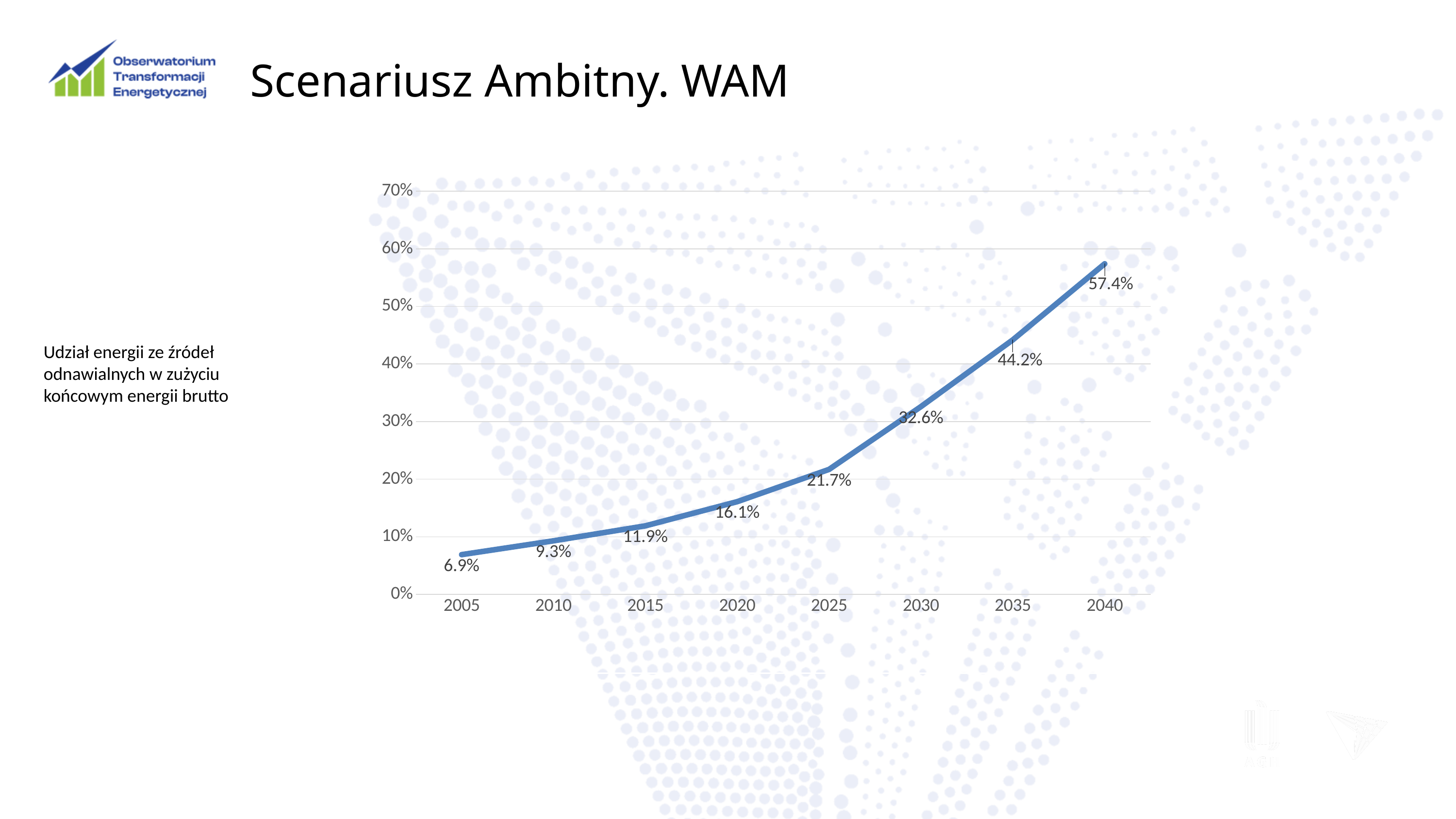
What is the difference between the values for 2020 and 2015? 4.2% What is the value for 2030? 32.6% Which year has the highest value? 2040 What kind of chart is shown on the slide? line chart How many data points are plotted on the line? 8 What is the value for 2040? 57.4% Do the values rise or fall from 2005 to 2040? rise What is the value for 2005? 6.9% What is the value for 2025? 21.7% What is the difference between the values for 2040 and 2035? 13.2% Which year has the lowest value? 2005 Which is larger, the value for 2010 or the value for 2020? 2020